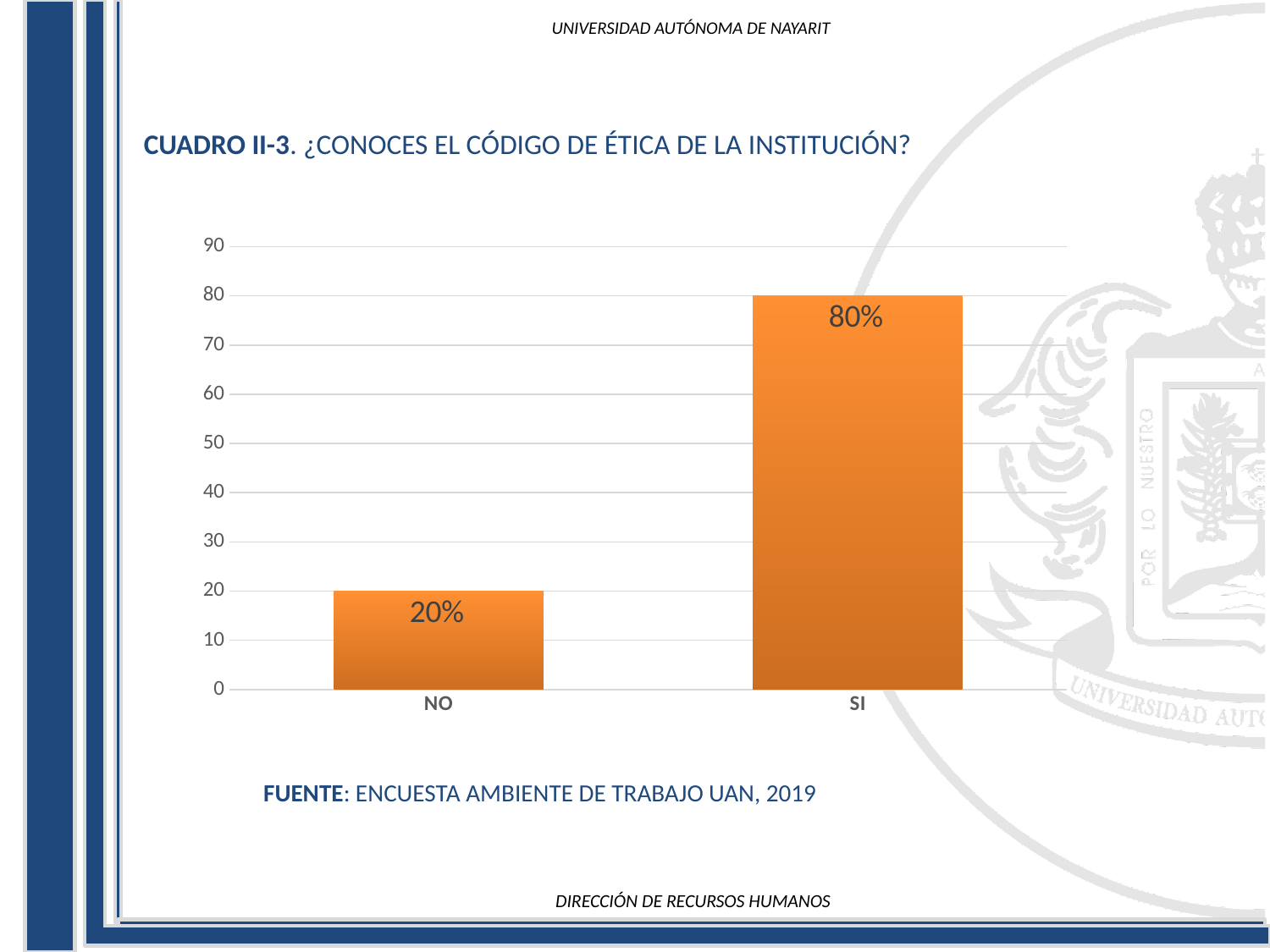
What colour are the bars in the chart? orange Which category has the highest value? SI Is the value for SI greater or less than 50? greater Which is larger, the value for NO or the value for SI? SI What is the value for NO? 20% Which category has the lowest value? NO Is the value for NO greater or less than 30? less How many categories are shown on the x axis? 2 What kind of chart is shown on the slide? bar chart What is the difference between the values for SI and NO? 60% What is the highest value shown on the vertical axis? 90 What is the value for SI? 80%